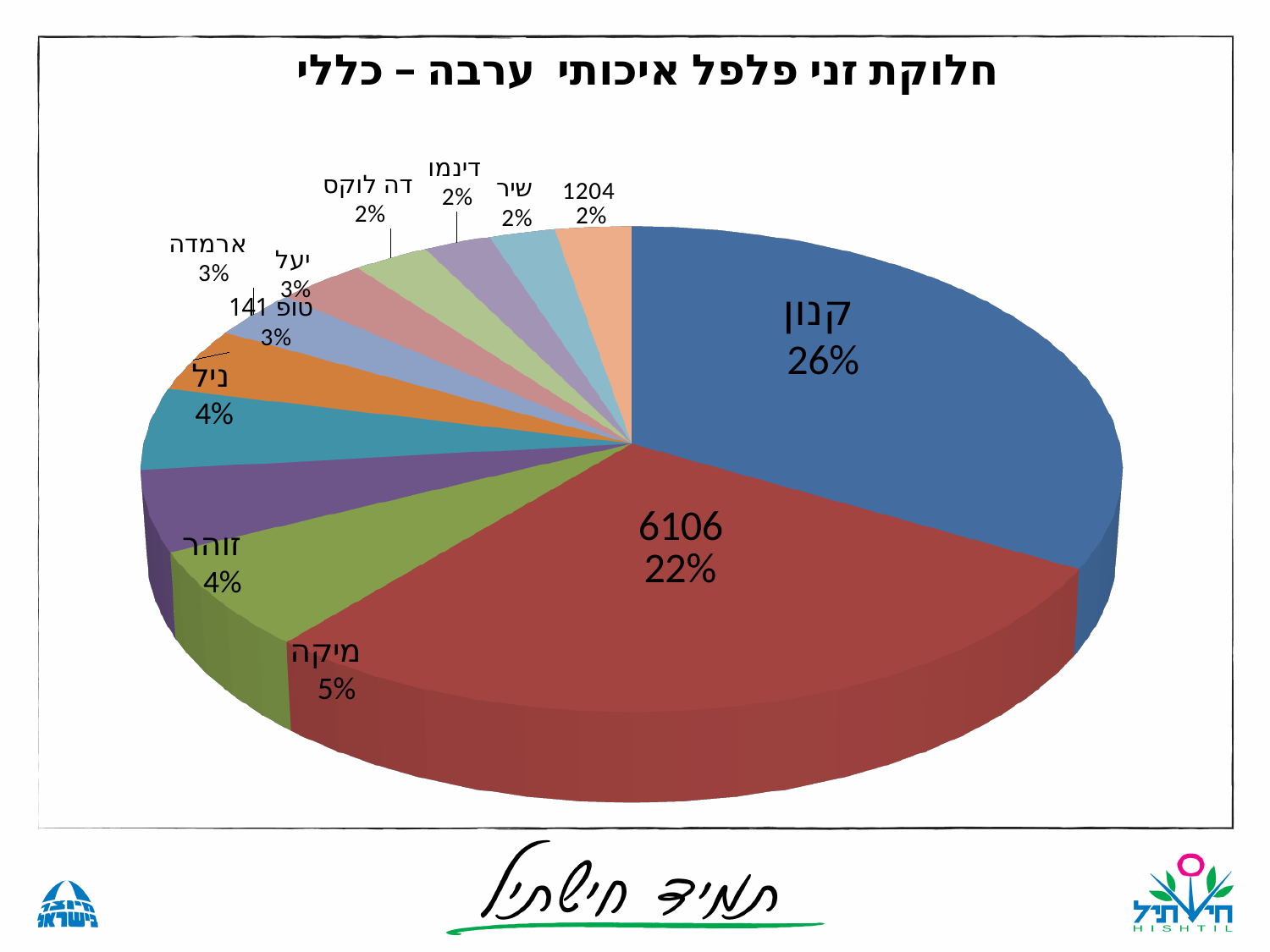
What percentage is shown for זוהר? 4% Which is larger, the slice for קנון or the slice for 6106? קנון What is the difference in percentage points between קנון and 6106? 4 What share of the pie does קנון hold? 26% What percentage is shown for מיקה? 5% What percentage is shown for ארמדה? 3% Which variety has the largest slice of the pie? קנון What percentage is shown for ניל? 4% What share of the pie does 6106 hold? 22% What is the title of the chart? חלוקת זני פלפל איכותי ערבה – כללי What kind of chart is shown on the slide? pie chart What percentage is shown for דינמו? 2%